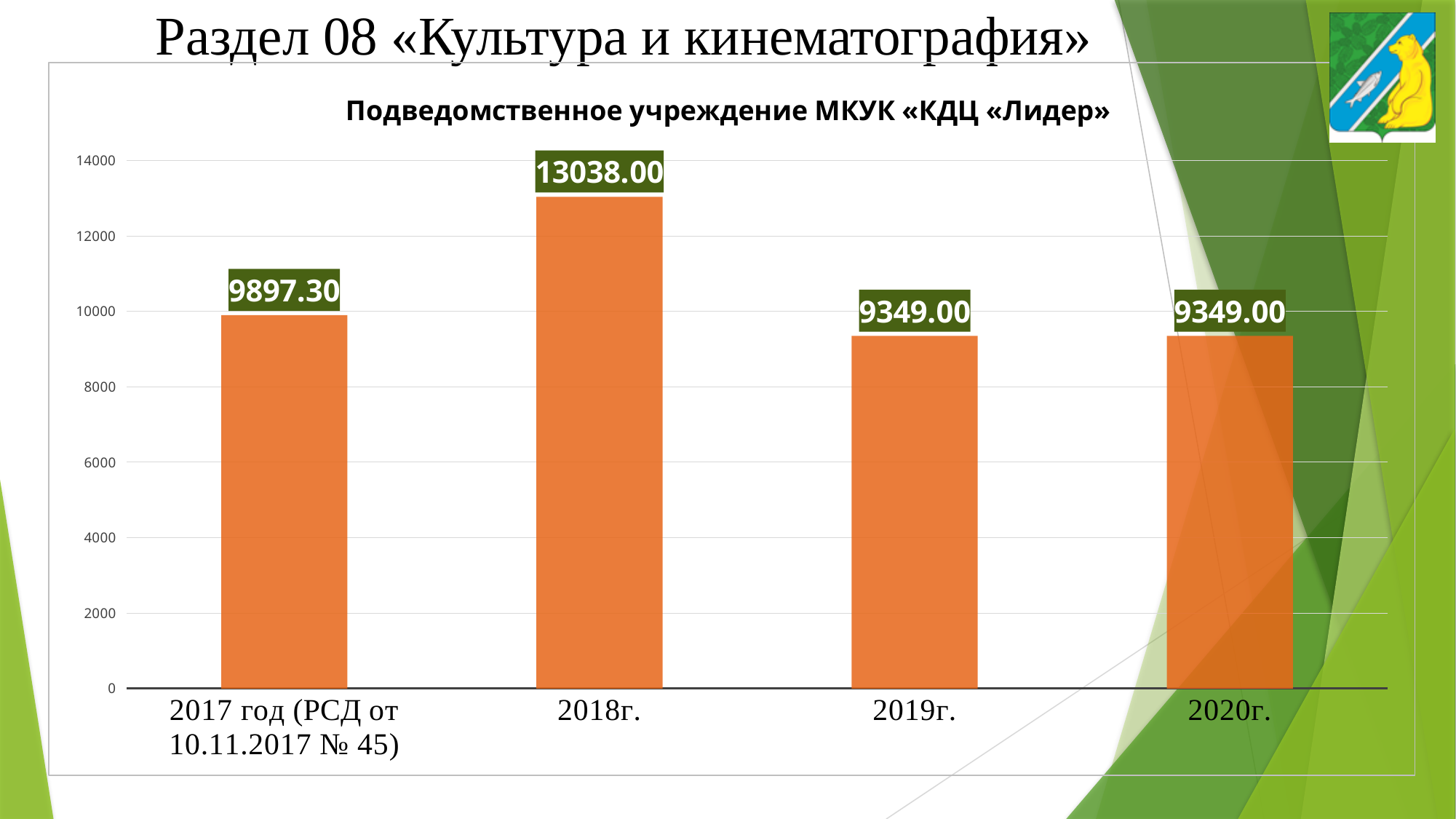
Which is larger, the value for 2017 год (РСД от 10.11.2017 № 45) or the value for 2019г.? 2017 год (РСД от 10.11.2017 № 45) What is the difference between the values for 2017 год (РСД от 10.11.2017 № 45) and 2020г.? 548.30 Is the value for 2018г. greater or less than 12000? greater What is the value for 2019г.? 9349.00 What kind of chart is shown on the slide? bar chart How many categories are shown on the x axis? 4 What is the value for 2020г.? 9349.00 What is the difference between the values for 2018г. and 2019г.? 3689.00 What is the value for 2017 год (РСД от 10.11.2017 № 45)? 9897.30 What is the title of the chart? Подведомственное учреждение МКУК «КДЦ «Лидер» Which category has the highest value? 2018г. What is the value for 2018г.? 13038.00